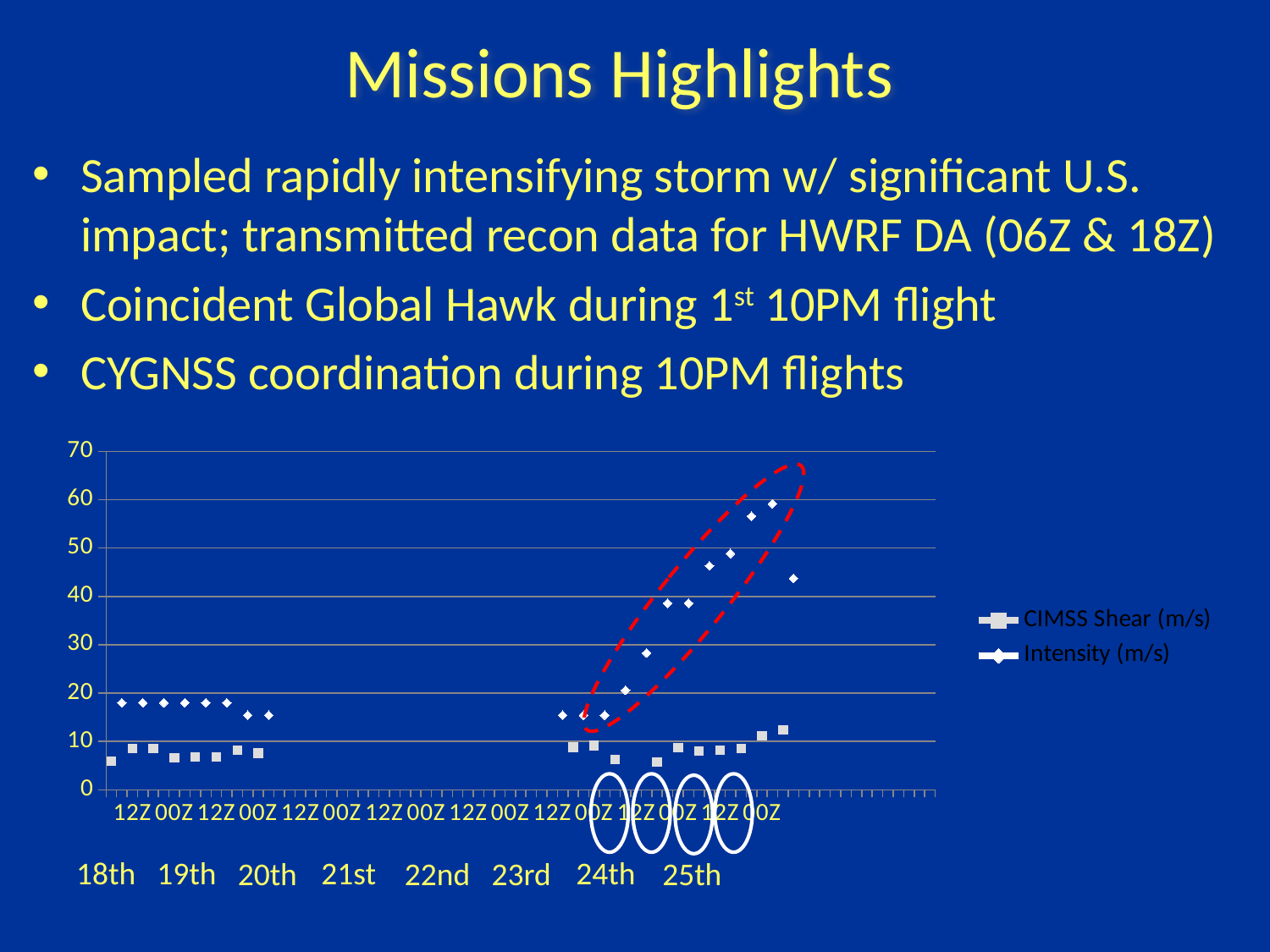
What is the first date label shown beneath the chart's x axis? 18th Does the Intensity (m/s) series rise or fall from the 23rd to the 25th? rise Is the highest Intensity (m/s) value on the chart greater or less than 50? greater Are all of the CIMSS Shear (m/s) values on the chart greater or less than 20? less What are the two series named in the chart legend? CIMSS Shear (m/s) and Intensity (m/s) What is the highest value shown on the chart's vertical axis? 70 On the 25th, which series has the larger values, Intensity (m/s) or CIMSS Shear (m/s)? Intensity (m/s) Is the Intensity (m/s) value at the first point on the 18th greater or less than 20? less How many series does the chart legend list? 2 Which series reaches the highest value on the chart? Intensity (m/s)